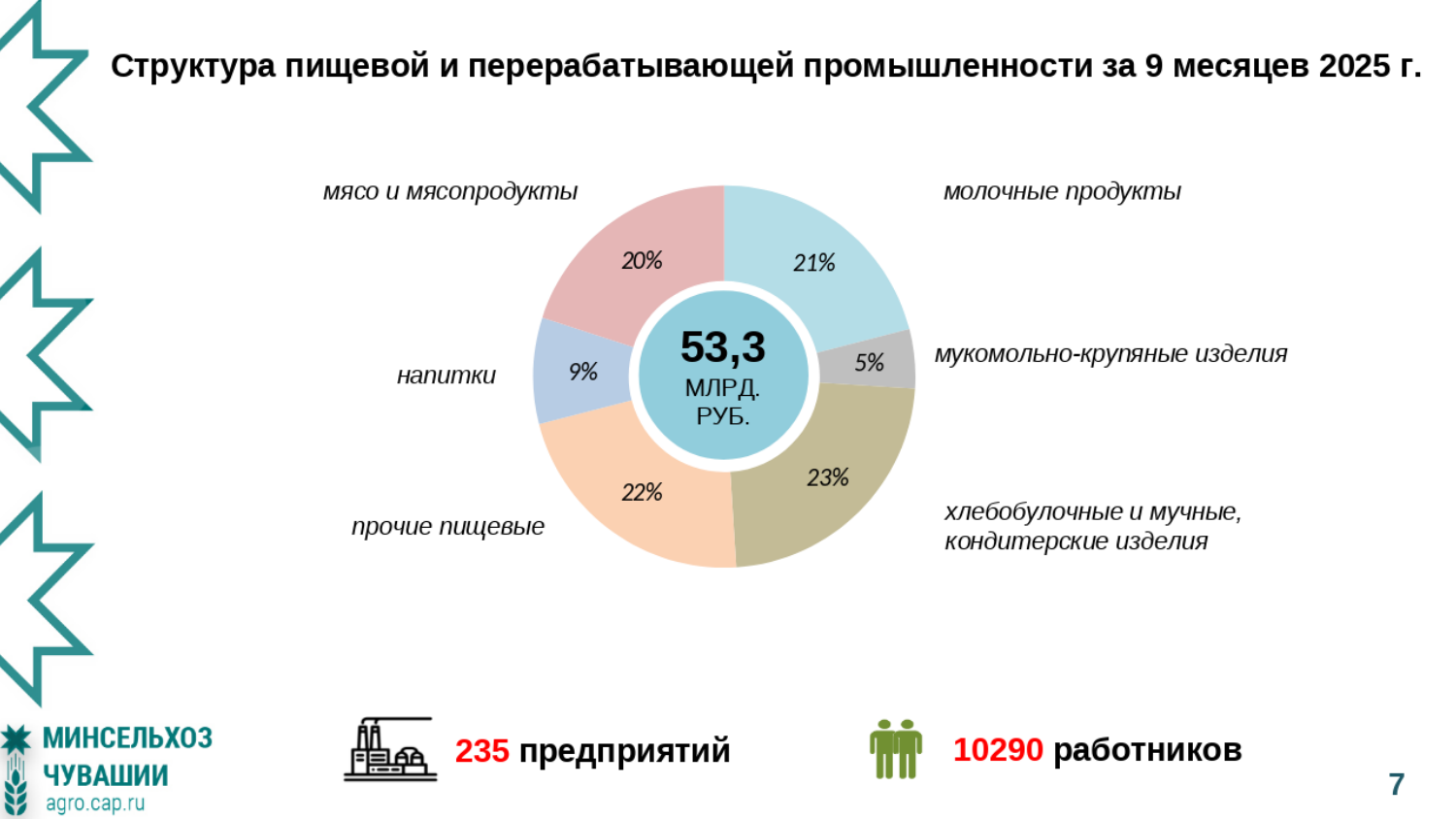
Какая доля приходится на напитки? 9% Какой тип диаграммы показан на слайде? кольцевая (круговая) диаграмма Какая категория имеет наименьшую долю? мукомольно-крупяные изделия Какова сумма долей напитков и мукомольно-крупяных изделий? 14% На сколько процентных пунктов доля прочих пищевых продуктов больше доли напитков? 13 Какое значение указано в центре диаграммы? 53,3 млрд. руб. Какая доля приходится на мукомольно-крупяные изделия? 5% Какая доля приходится на молочные продукты? 21% Какая доля приходится на мясо и мясопродукты? 20% Сколько категорий показано на диаграмме? 6 Что больше: доля молочных продуктов или доля мяса и мясопродуктов? молочные продукты Какая категория имеет наибольшую долю? хлебобулочные и мучные, кондитерские изделия